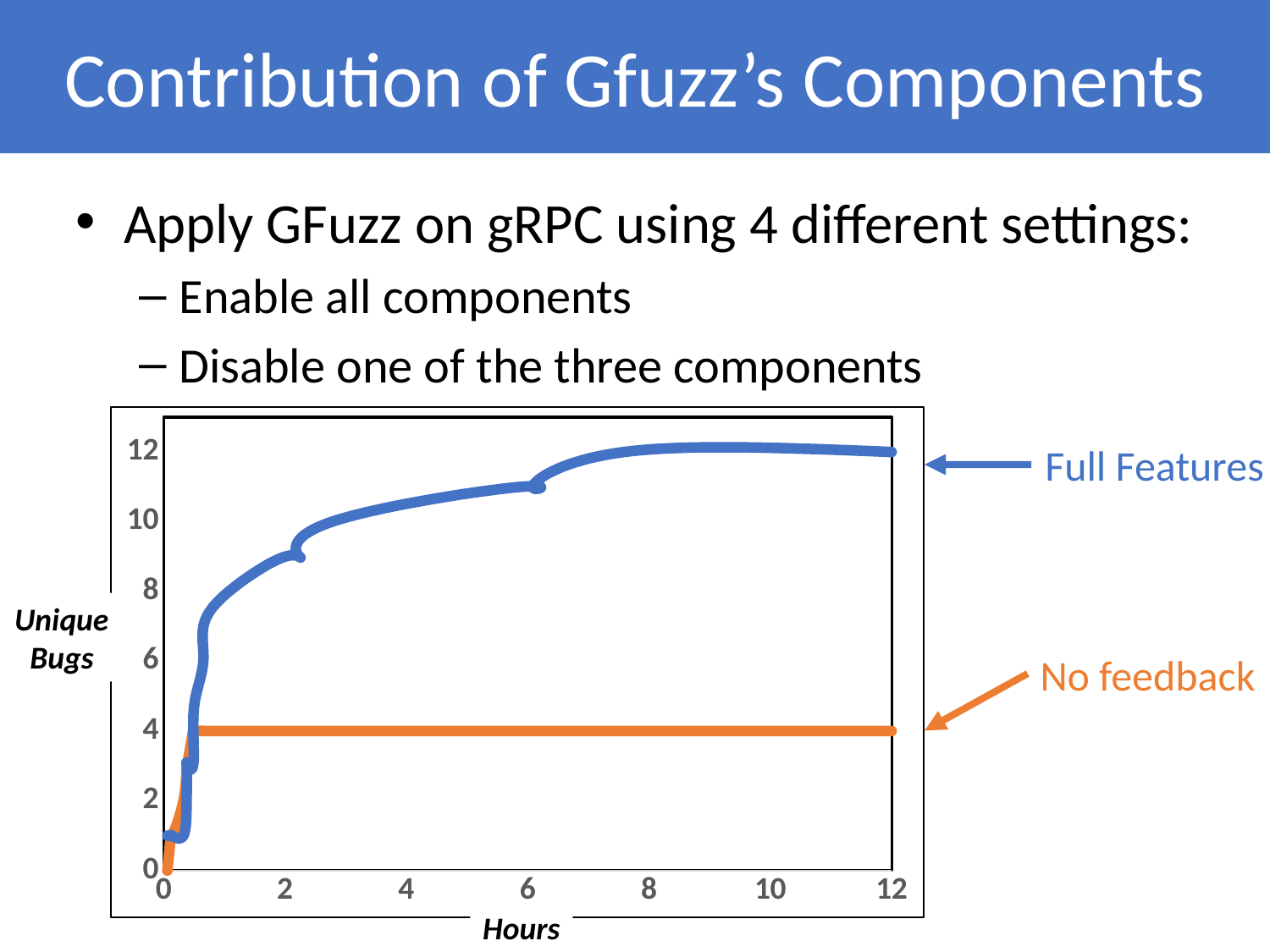
How does the Full Features line change as hours increase? rises Is the Full Features value at 4 hours greater or less than 8? greater How many series are plotted in the chart? 2 Which series has the higher number of unique bugs at 12 hours, Full Features or No feedback? Full Features What kind of chart is shown on the slide? line chart What is the label of the x axis? Hours Is the No feedback value at 8 hours greater or less than 6? less Is the Full Features value at 6 hours greater or less than 10? greater What colour is the Full Features line? blue Does the No feedback line rise, fall, or stay flat after the first hour? stays flat How many unique bugs does the No feedback series reach at 12 hours? 4